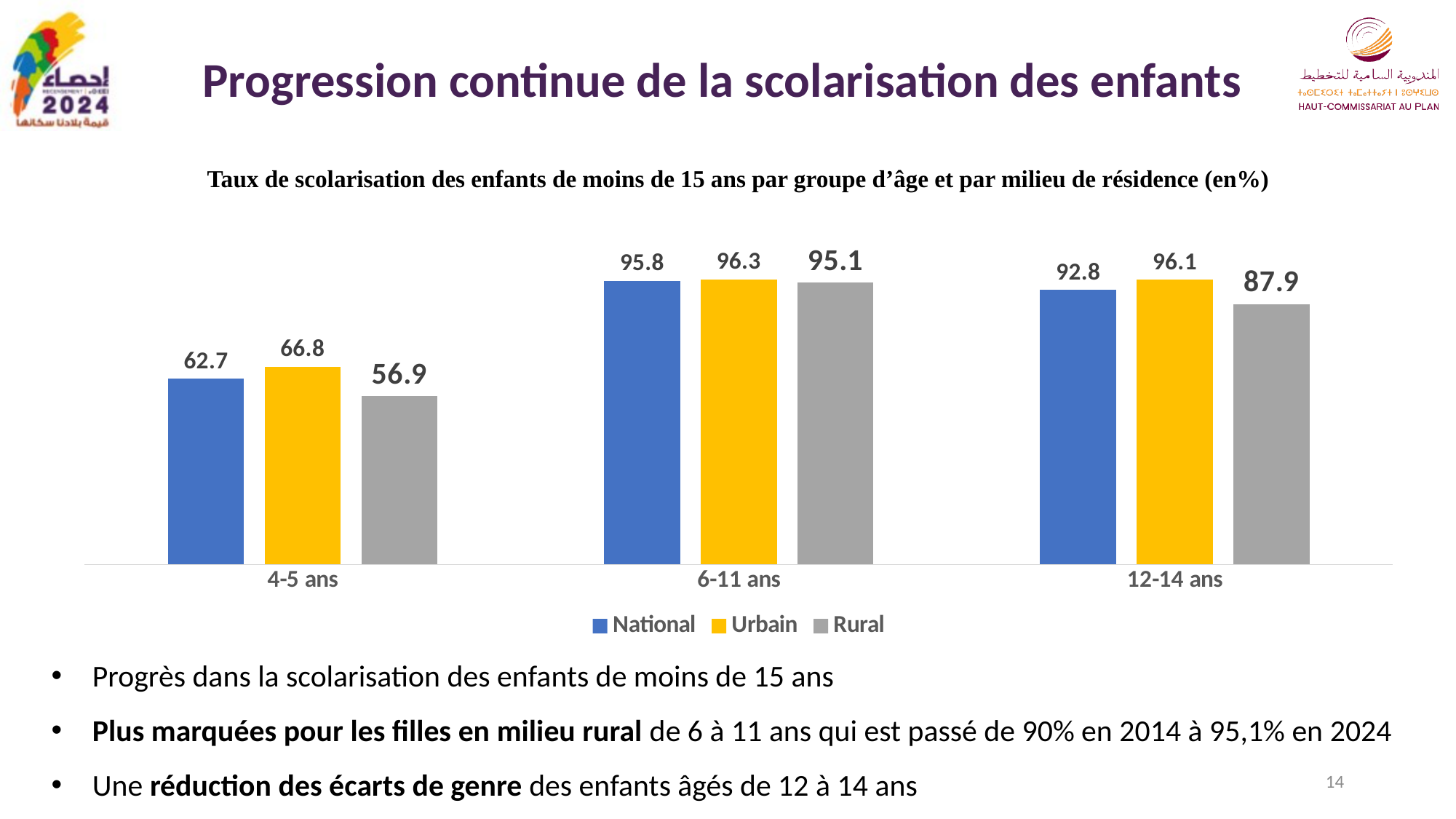
What is the difference between the National values for 6-11 ans and 4-5 ans? 33.1 Which colour represents the Rural series in the chart? Grey Which age group has the highest Urbain value? 6-11 ans What is the difference between the Urbain and Rural values for the 12-14 ans age group? 8.2 Which age group has the lowest Rural value? 4-5 ans What is the Urbain value for the 4-5 ans age group? 66.8 What is the National value for the 6-11 ans age group? 95.8 Which is larger for the 4-5 ans age group, the National value or the Rural value? National What is the Rural value for the 12-14 ans age group? 87.9 How many series does the legend list? 3 How many age groups are shown on the x axis? 3 What kind of chart is shown on the slide? Bar chart